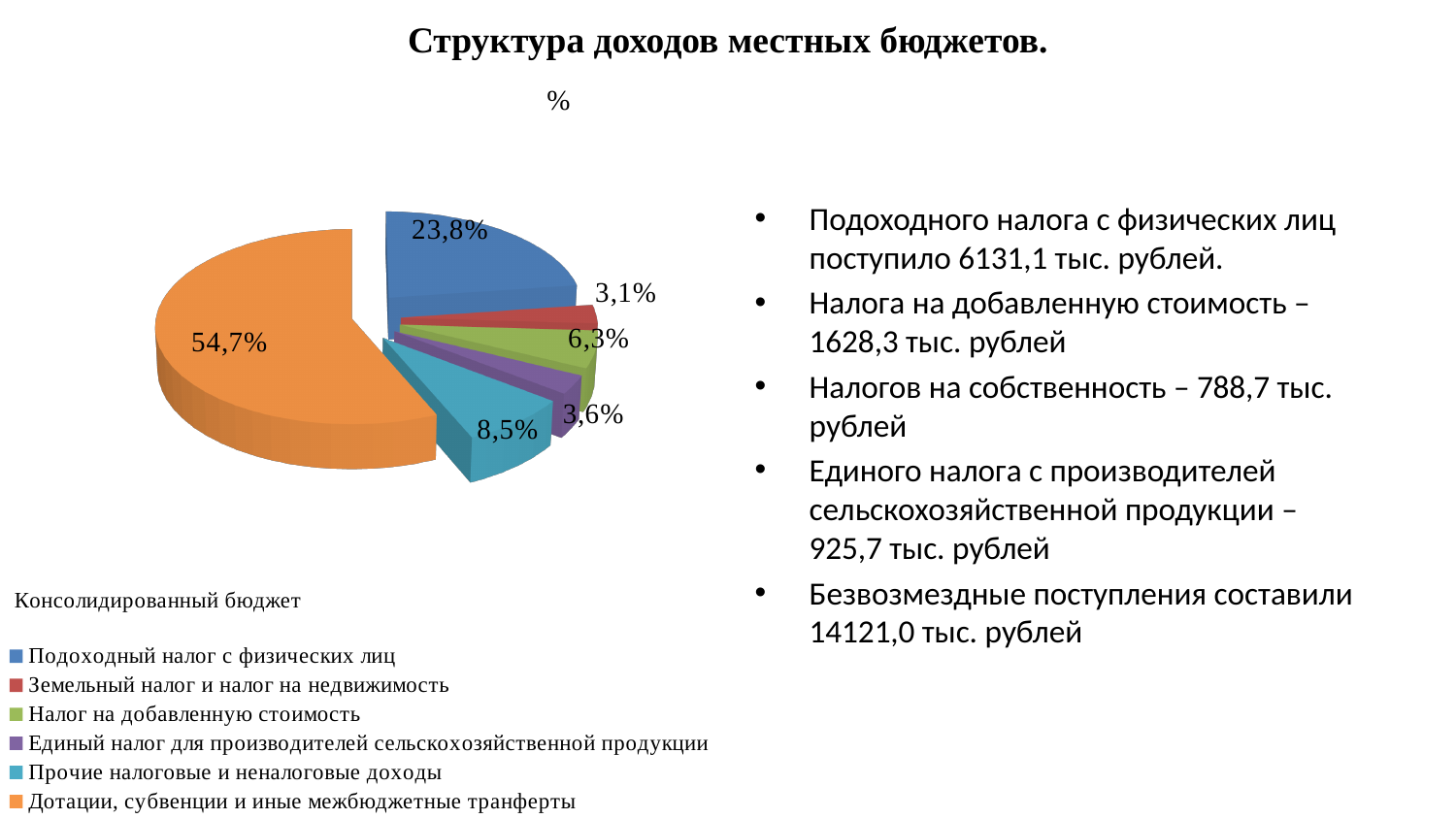
What colour is the slice for Прочие налоговые и неналоговые доходы? light blue (cyan) What percentage is shown for Дотации, субвенции и иные межбюджетные трансферты? 54,7% Which is larger: the share for Единый налог для производителей сельскохозяйственной продукции or the share for Налог на добавленную стоимость? Налог на добавленную стоимость What percentage is shown for Налог на добавленную стоимость? 6,3% How many entries does the legend list? 6 What type of chart is shown on the slide? pie chart What percentage is shown for Прочие налоговые и неналоговые доходы? 8,5% What share of the pie is labelled for Подоходный налог с физических лиц? 23,8% Which category has the largest slice of the pie? Дотации, субвенции и иные межбюджетные трансферты What is the difference in percentage points between Дотации, субвенции и иные межбюджетные трансферты and Подоходный налог с физических лиц? 30,9 Which category has the smallest slice of the pie? Земельный налог и налог на недвижимость How many slices does the pie chart have? 6